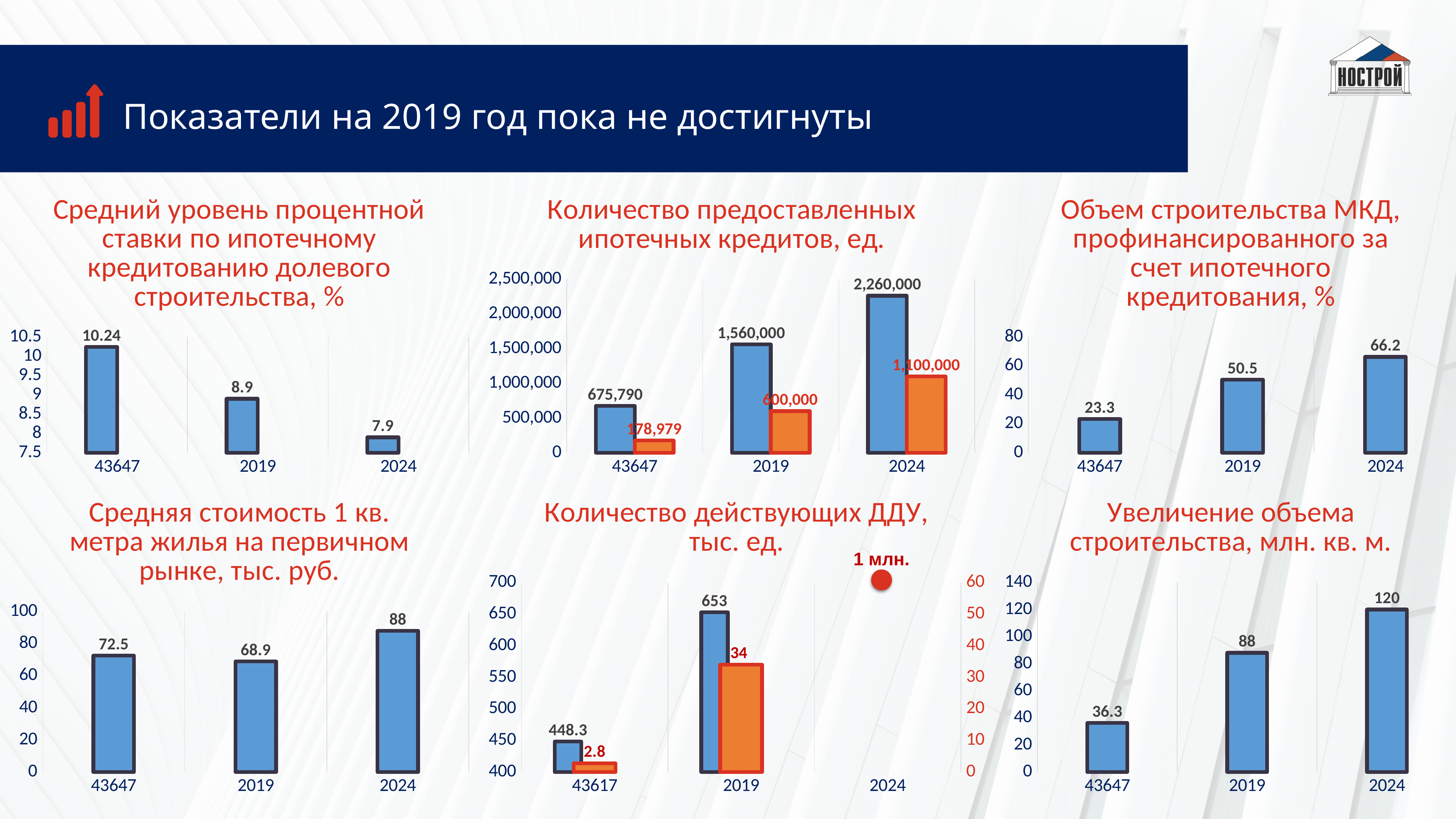
In the chart 'Количество предоставленных ипотечных кредитов, ед.', what is the value of the blue bar for 2024? 2,260,000 In the chart 'Объем строительства МКД, профинансированного за счет ипотечного кредитования, %', do the values rise or fall from left to right? rise In the chart 'Объем строительства МКД, профинансированного за счет ипотечного кредитования, %', what is the value for 2019? 50.5 In the chart 'Средний уровень процентной ставки по ипотечному кредитованию долевого строительства, %', which category has the highest value? 43647 In the chart 'Средняя стоимость 1 кв. метра жилья на первичном рынке, тыс. руб.', what is the difference between the values for 2024 and 43647? 15.5 In the chart 'Количество предоставленных ипотечных кредитов, ед.', what is the difference between the blue and orange bars for 2024? 1,160,000 In the chart 'Количество предоставленных ипотечных кредитов, ед.', what is the value of the orange bar for 2019? 600,000 In the chart 'Количество действующих ДДУ, тыс. ед.', what is the value of the orange bar for 2019? 34 In the chart 'Увеличение объема строительства, млн. кв. м.', what is the value for 43647? 36.3 How many charts are shown on the slide? 6 In the chart 'Средний уровень процентной ставки по ипотечному кредитованию долевого строительства, %', what is the value for 2024? 7.9 In the chart 'Средняя стоимость 1 кв. метра жилья на первичном рынке, тыс. руб.', which category has the lowest value? 2019